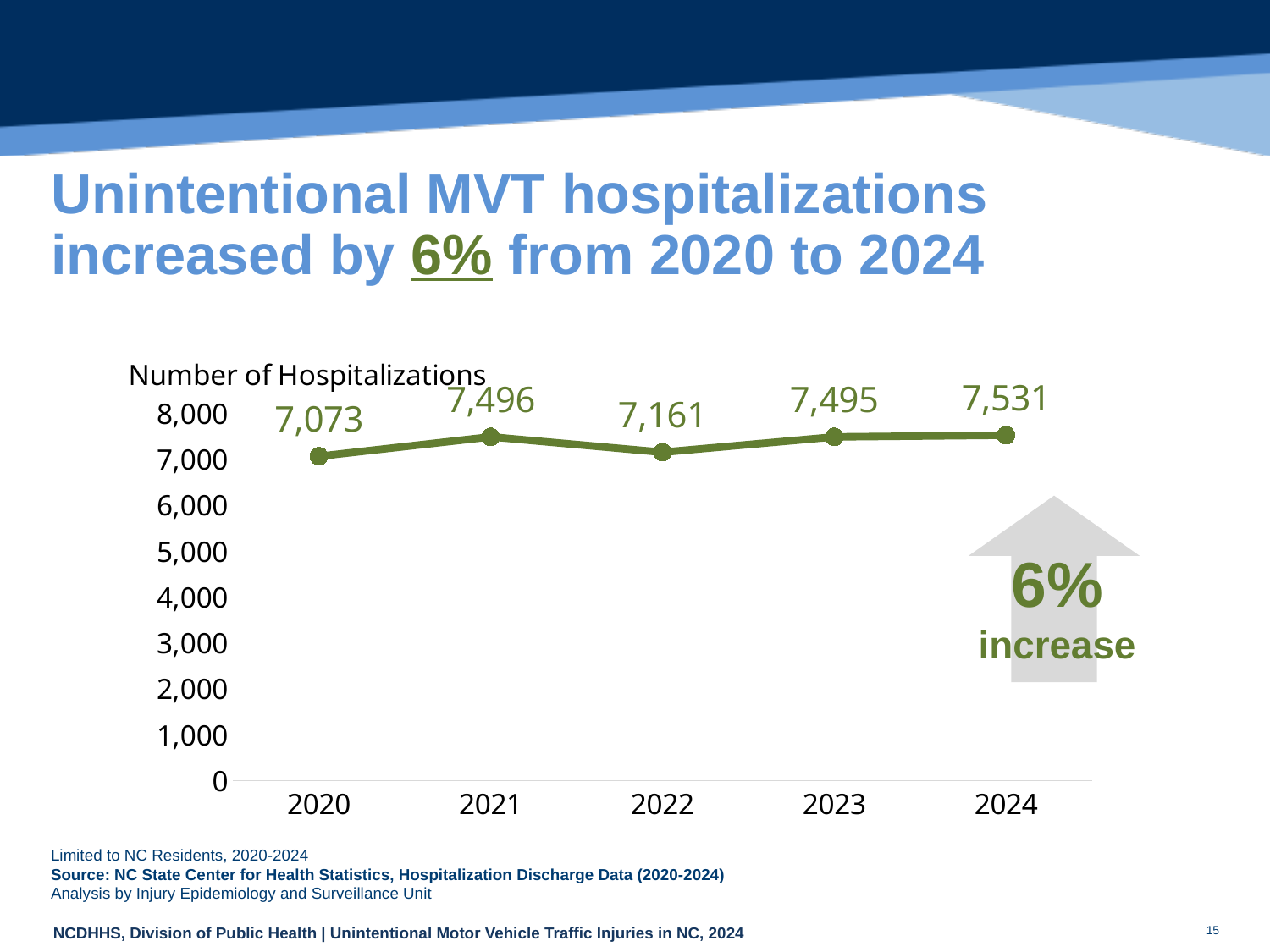
What is the title of the chart's axis label shown above the y axis? Number of Hospitalizations What kind of chart is shown on the slide? line chart What is the difference in hospitalizations between 2021 and 2022? 335 What is the difference in hospitalizations between 2024 and 2020? 458 What is the number of hospitalizations in 2020? 7,073 How many years are plotted on the chart? 5 What is the number of hospitalizations in 2022? 7,161 What is the number of hospitalizations in 2024? 7,531 Which year has the highest number of hospitalizations? 2024 Is the value for 2023 greater or less than 7,000? greater Which year has the lowest number of hospitalizations? 2020 Which year had more hospitalizations, 2021 or 2022? 2021